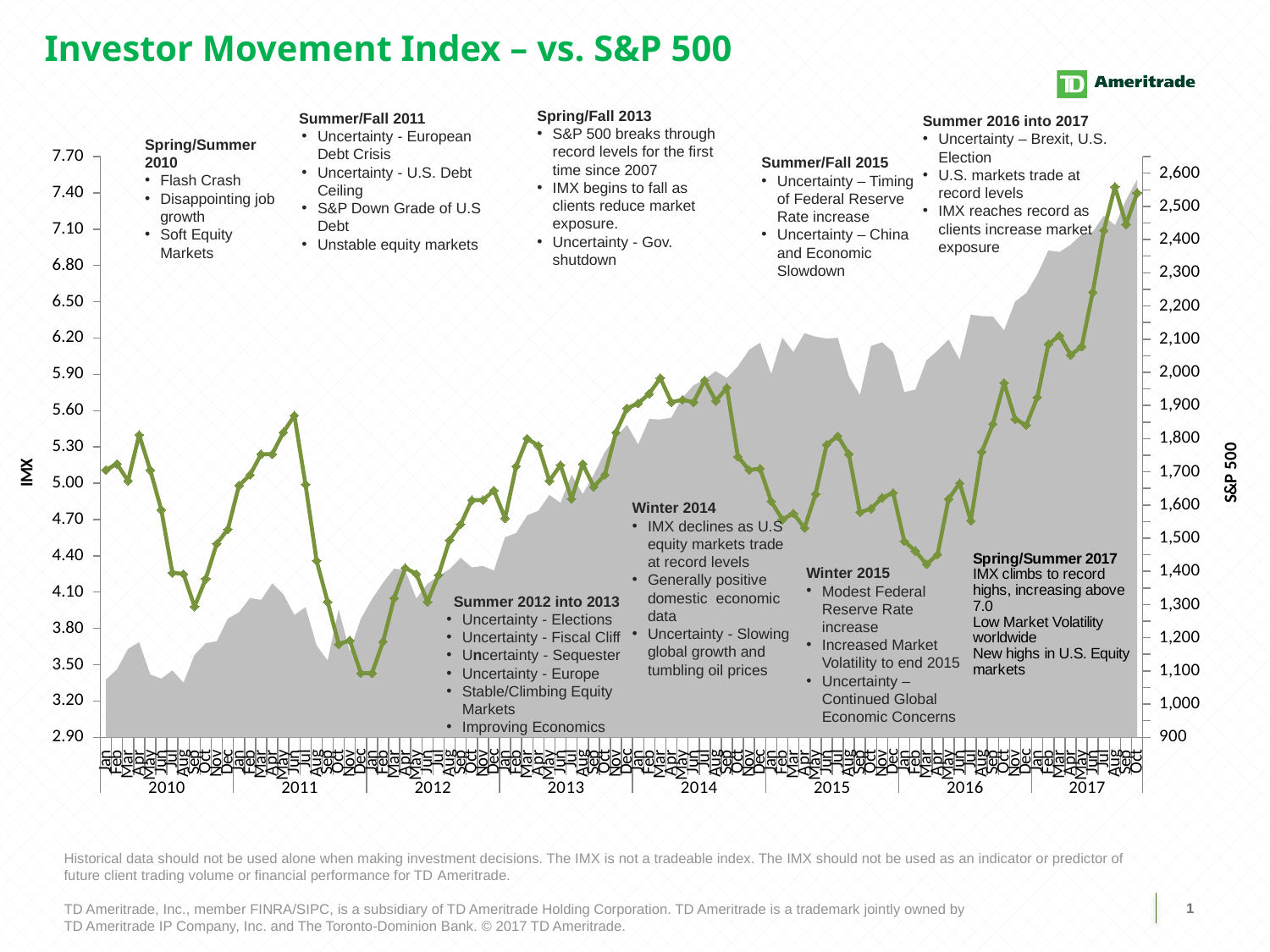
Is the S&P 500 value in October 2017 greater or less than 2,400? greater Does the IMX line rise or fall between January 2012 and March 2013? Rise Is the IMX value in August 2017 greater or less than 7.10? greater Overall, does the S&P 500 area rise or fall from 2010 to 2017? Rise In which year does the IMX line reach its highest point? 2017 Which is higher, the IMX value in August 2017 or the IMX value in January 2010? August 2017 Is the IMX value in December 2011 greater or less than 3.80? less What label is shown on the left vertical axis of the chart? IMX What kind of chart is used to plot the IMX series on this slide? Line chart How many years are labelled along the x axis of the chart? 8 What is the title of the chart on this slide? Investor Movement Index – vs. S&P 500